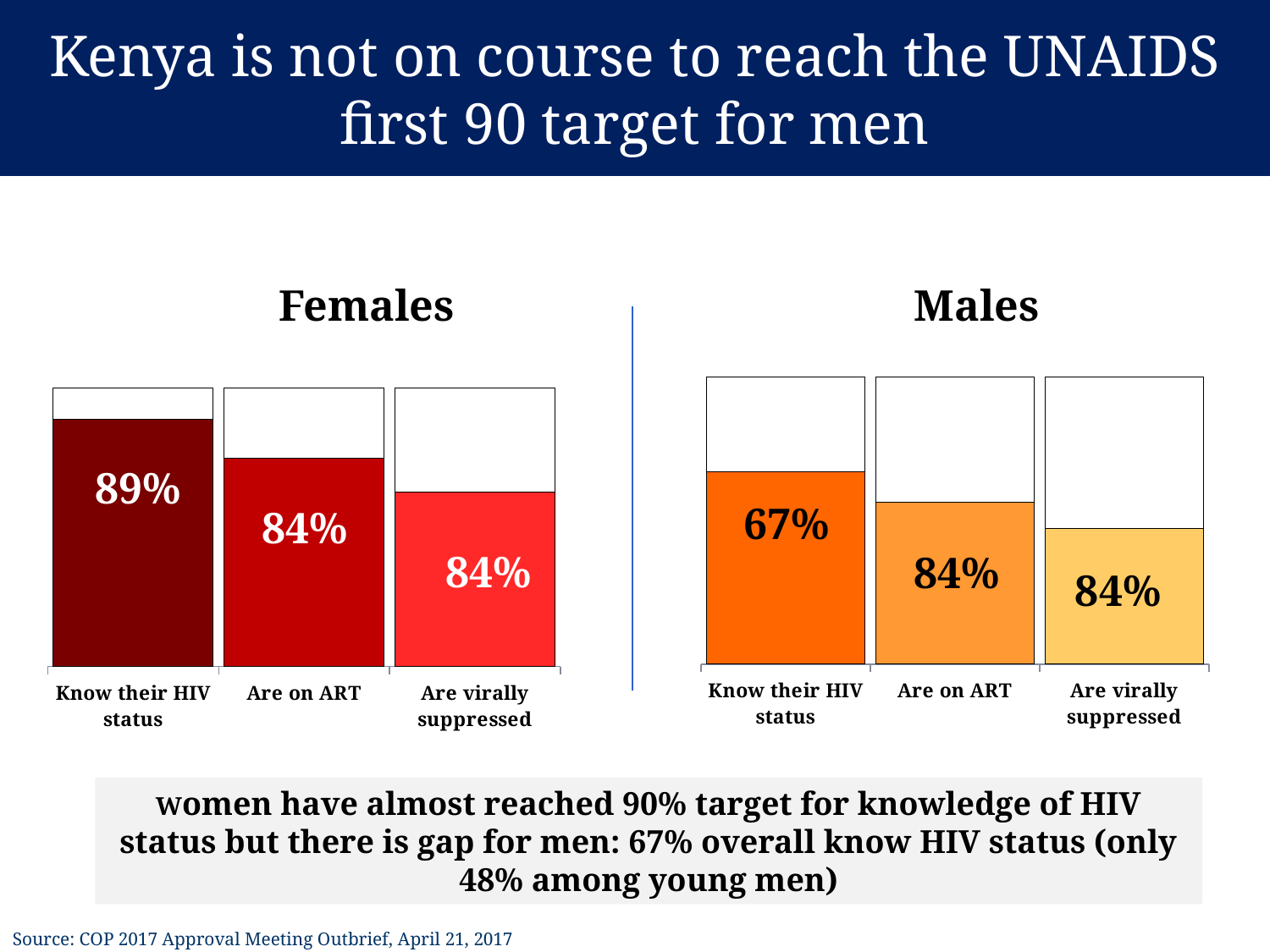
What is the title of the chart on the right side of the slide? Males In the Females chart, what is the difference between the 'Know their HIV status' value and the 'Are on ART' value? 5% What type of chart is the Females chart? Bar chart In the Males chart, what percentage are virally suppressed? 84% In the Females chart, which category has the highest value? Know their HIV status How many categories are shown in the Males chart? 3 In the Males chart, what percentage know their HIV status? 67% What is the difference between the percentage of females and males who know their HIV status? 22% In the Males chart, which category has the lowest value? Know their HIV status In the Females chart, what percentage are on ART? 84% In the Females chart, what percentage know their HIV status? 89% Which is larger: the percentage of females who know their HIV status or the percentage of males who know their HIV status? Females